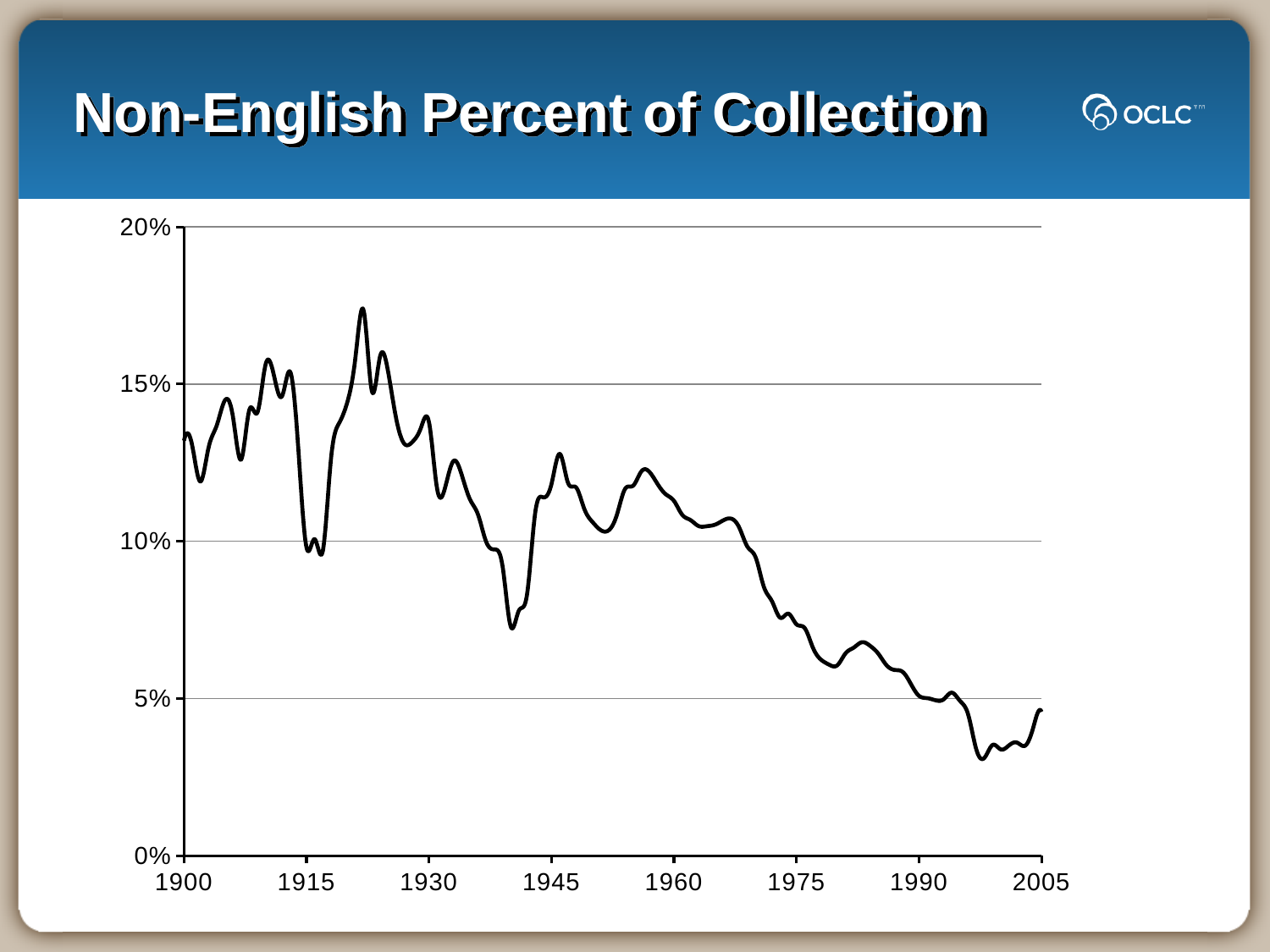
Is the value for 1900 greater or less than the value for 2005? greater Overall, does the non-English percent of collection rise or fall from 1900 to 2005? fall Is the value for 1960 greater or less than 10%? greater Is the value for 1975 greater or less than 10%? less What kind of chart is shown on the slide? line chart What is the highest value shown on the y axis? 20% Is the value for 1945 greater or less than the value for 1975? greater Is the value for 1900 greater or less than 10%? greater What is the title of the chart? Non-English Percent of Collection